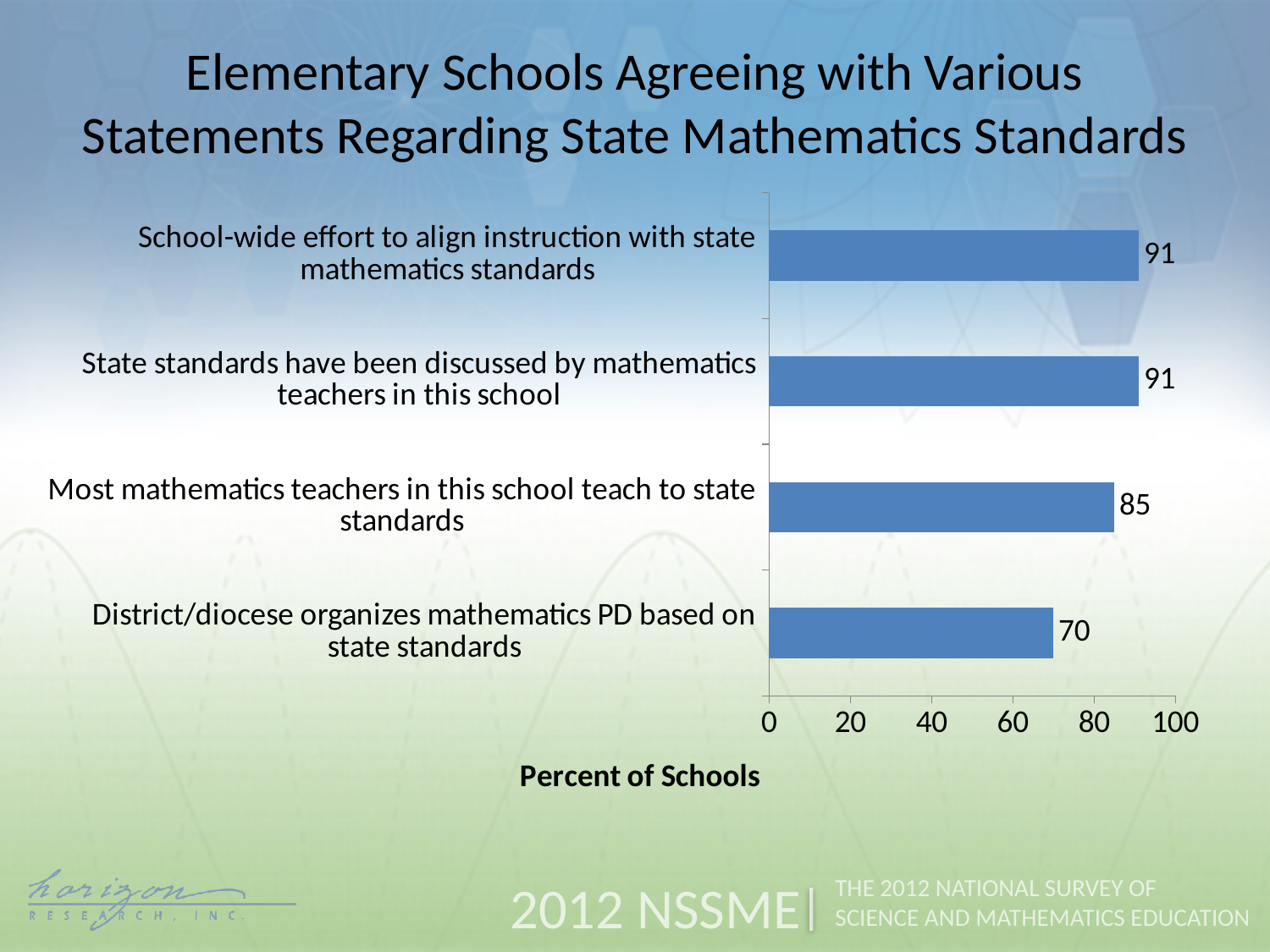
What value is shown for 'State standards have been discussed by mathematics teachers in this school'? 91 What value is shown for 'School-wide effort to align instruction with state mathematics standards'? 91 What kind of chart is shown on the slide? Bar chart How many statements are shown in the chart? 4 Which statement has the lowest percent of schools agreeing? District/diocese organizes mathematics PD based on state standards What is the difference between the value for 'Most mathematics teachers in this school teach to state standards' and the value for 'District/diocese organizes mathematics PD based on state standards'? 15 What is the label of the horizontal axis? Percent of Schools What percent of schools agree that the district/diocese organizes mathematics PD based on state standards? 70 Is the value for 'District/diocese organizes mathematics PD based on state standards' greater or less than 80? less What percent of schools agree that most mathematics teachers in this school teach to state standards? 85 What is the difference between the value for 'School-wide effort to align instruction with state mathematics standards' and the value for 'Most mathematics teachers in this school teach to state standards'? 6 Which is larger: the value for 'Most mathematics teachers in this school teach to state standards' or the value for 'District/diocese organizes mathematics PD based on state standards'? Most mathematics teachers in this school teach to state standards